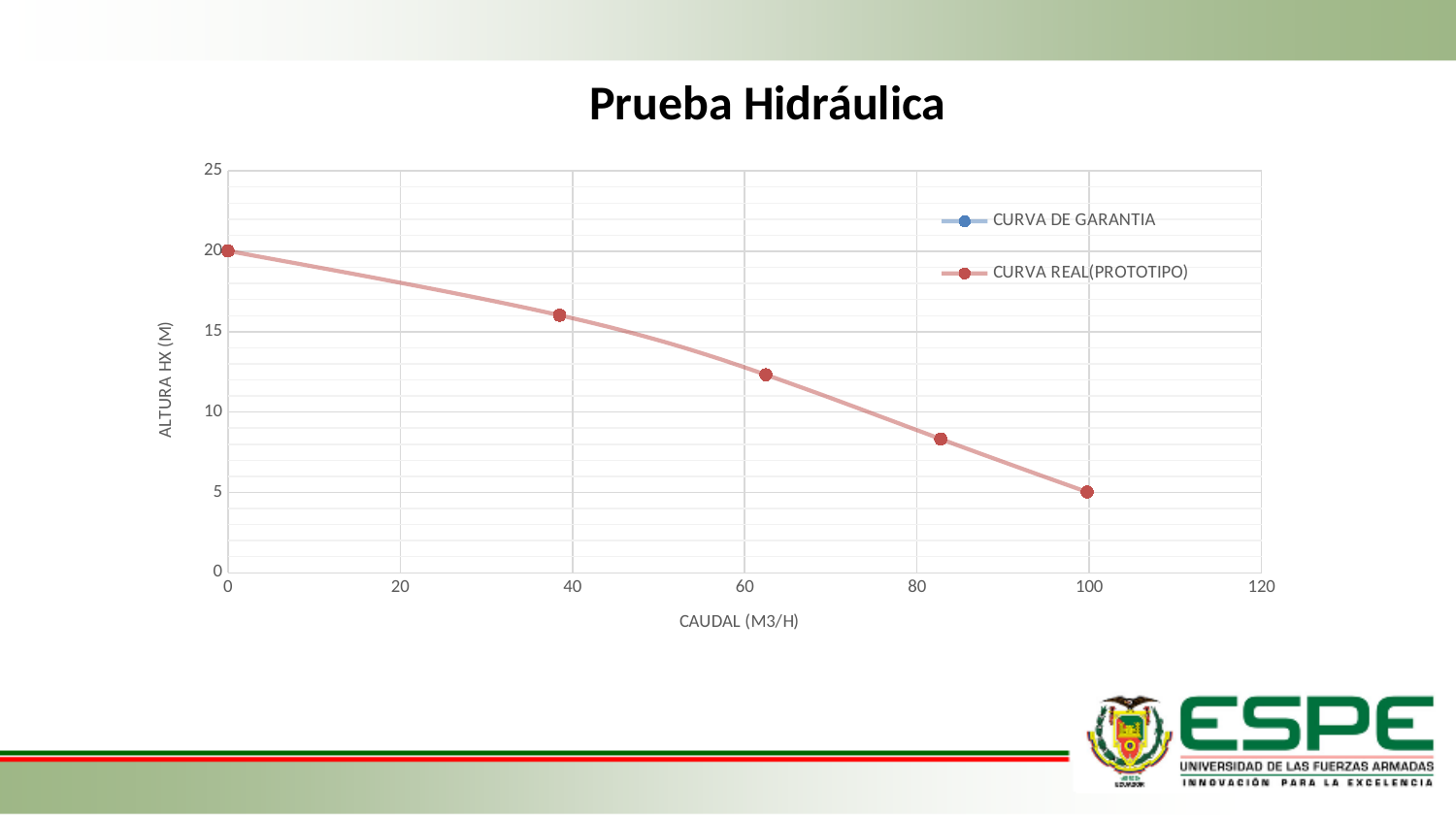
What is the title of the chart? Prueba Hidráulica Is the ALTURA value of the CURVA REAL(PROTOTIPO) point near CAUDAL 60 greater or less than 10? greater How many data points are plotted on the CURVA REAL(PROTOTIPO) series? 5 Does the CURVA REAL(PROTOTIPO) series rise or fall as CAUDAL increases? fall Is the ALTURA value of the CURVA REAL(PROTOTIPO) point near CAUDAL 80 greater or less than 10? less What kind of chart is shown on the slide? line chart At which CAUDAL value does the CURVA REAL(PROTOTIPO) series reach its highest ALTURA? 0 Is the ALTURA value of the CURVA REAL(PROTOTIPO) point near CAUDAL 40 greater or less than 15? greater How many series does the legend list? 2 What is the label of the x axis? CAUDAL (M3/H) Which has the larger ALTURA on the CURVA REAL(PROTOTIPO) series: the point near CAUDAL 40 or the point near CAUDAL 80? the point near CAUDAL 40